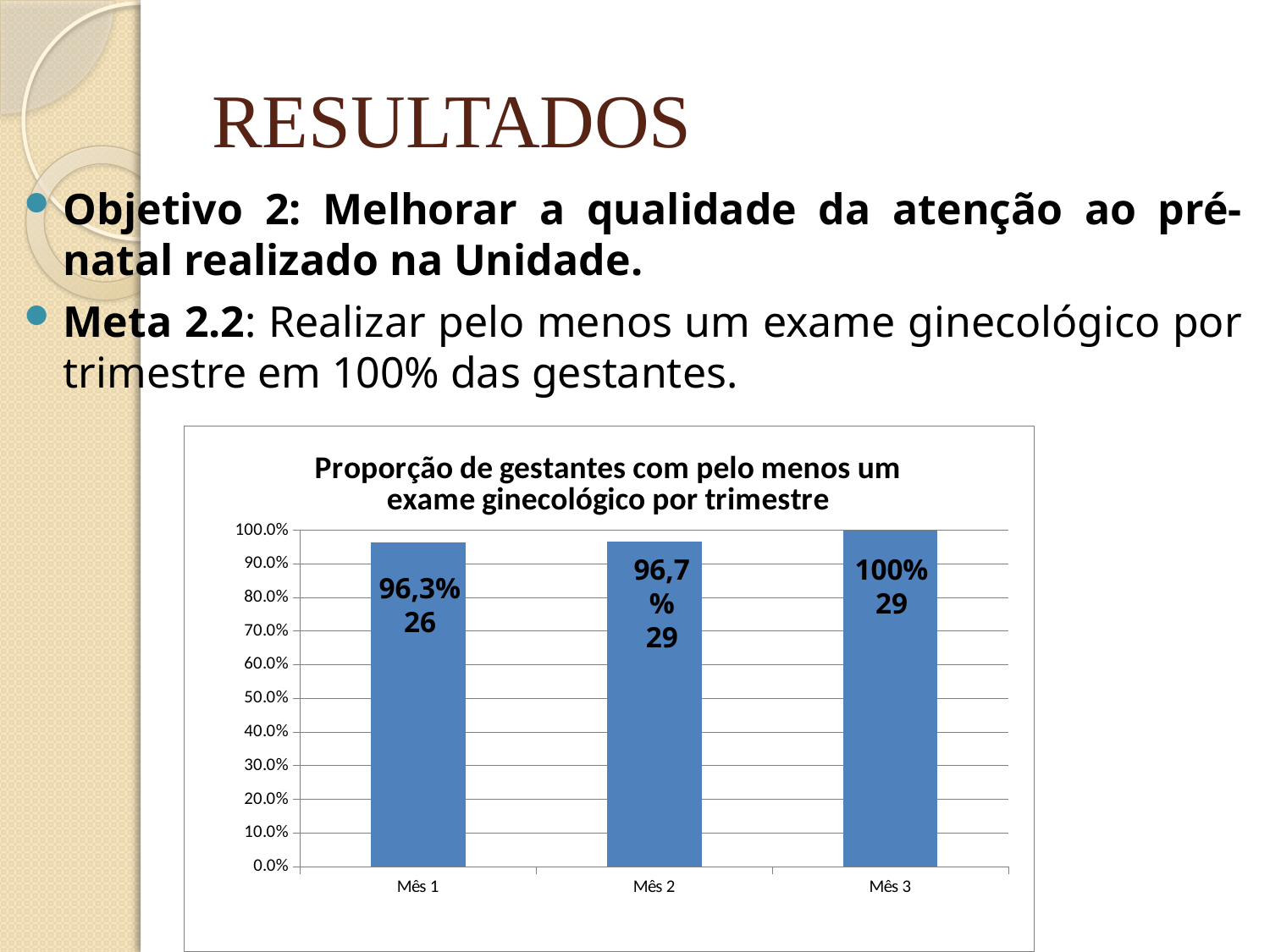
Which month has the highest proportion? Mês 3 What is the value for Mês 3? 100% Which month has the lowest proportion? Mês 1 What is the value for Mês 1? 96,3% Is the value for Mês 1 greater or less than 90.0%? greater What kind of chart is shown? Bar chart What count is shown on the bar for Mês 3? 29 What is the difference between the values for Mês 3 and Mês 1? 3,7% What is the value for Mês 2? 96,7% How many months are shown on the x axis? 3 What count is shown on the bar for Mês 1? 26 Do the values rise or fall from Mês 1 to Mês 3? Rise